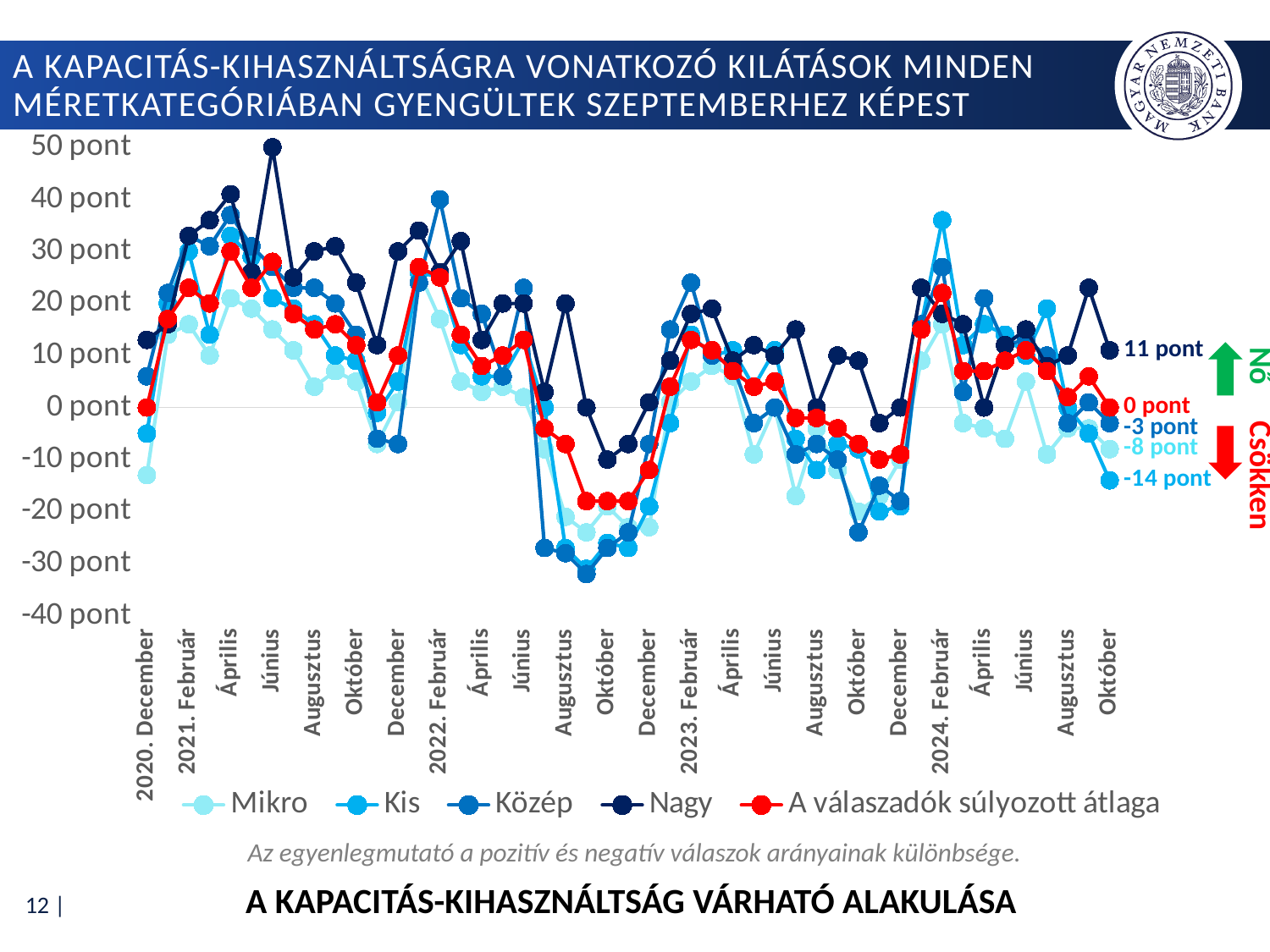
Which series has the highest value at the last data point (2024 Október)? Nagy What is the value of 'A válaszadók súlyozott átlaga' at the last data point (2024 Október)? 0 pont What is the value of the Nagy series at the last data point (2024 Október)? 11 pont How many series does the legend list? 5 What is the title of the chart shown at the bottom of the slide? A KAPACITÁS-KIHASZNÁLTSÁG VÁRHATÓ ALAKULÁSA Which series has the lowest value at the last data point (2024 Október)? Kis What is the value of the Kis series at the last data point (2024 Október)? -14 pont Is the value of the Nagy series in 2021 Június greater or less than 40 pont? greater What kind of chart is shown on the slide? line chart What is the value of the Közép series at the last data point (2024 Október)? -3 pont What is the value of the Mikro series at the last data point (2024 Október)? -8 pont What is the difference between the Nagy and Kis values at the last data point (2024 Október)? 25 pont